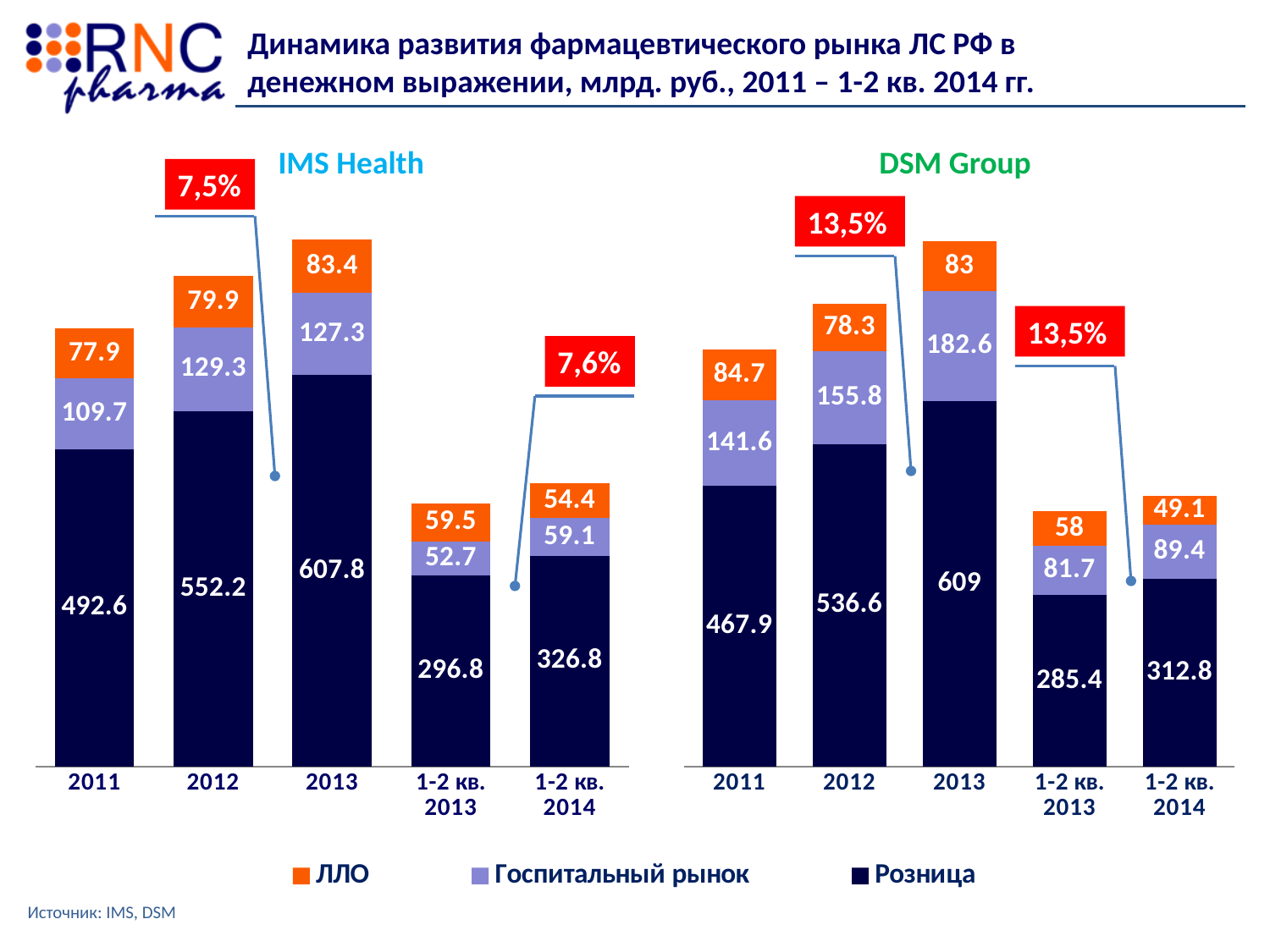
In the DSM Group chart, what is the total of the stacked bar for 1-2 кв. 2014? 451.3 In the DSM Group chart, what is the value of ЛЛО for 1-2 кв. 2014? 49.1 How many series does the legend list? 3 In the IMS Health chart, what is the value of Розница for 2013? 607.8 In the IMS Health chart, which category has the highest Розница value? 2013 In the DSM Group chart, what is the value of Госпитальный рынок for 2012? 155.8 What type of chart is the DSM Group chart? Stacked bar chart In the DSM Group chart, which category has the lowest Розница value? 1-2 кв. 2013 How many categories are shown on the x axis of the IMS Health chart? 5 In the IMS Health chart, what is the difference between the Розница values for 2012 and 2011? 59.6 In the DSM Group chart, which is larger: Госпитальный рынок for 2013 or for 2011? 2013 In the IMS Health chart, what is the total of the stacked bar for 2011? 680.2